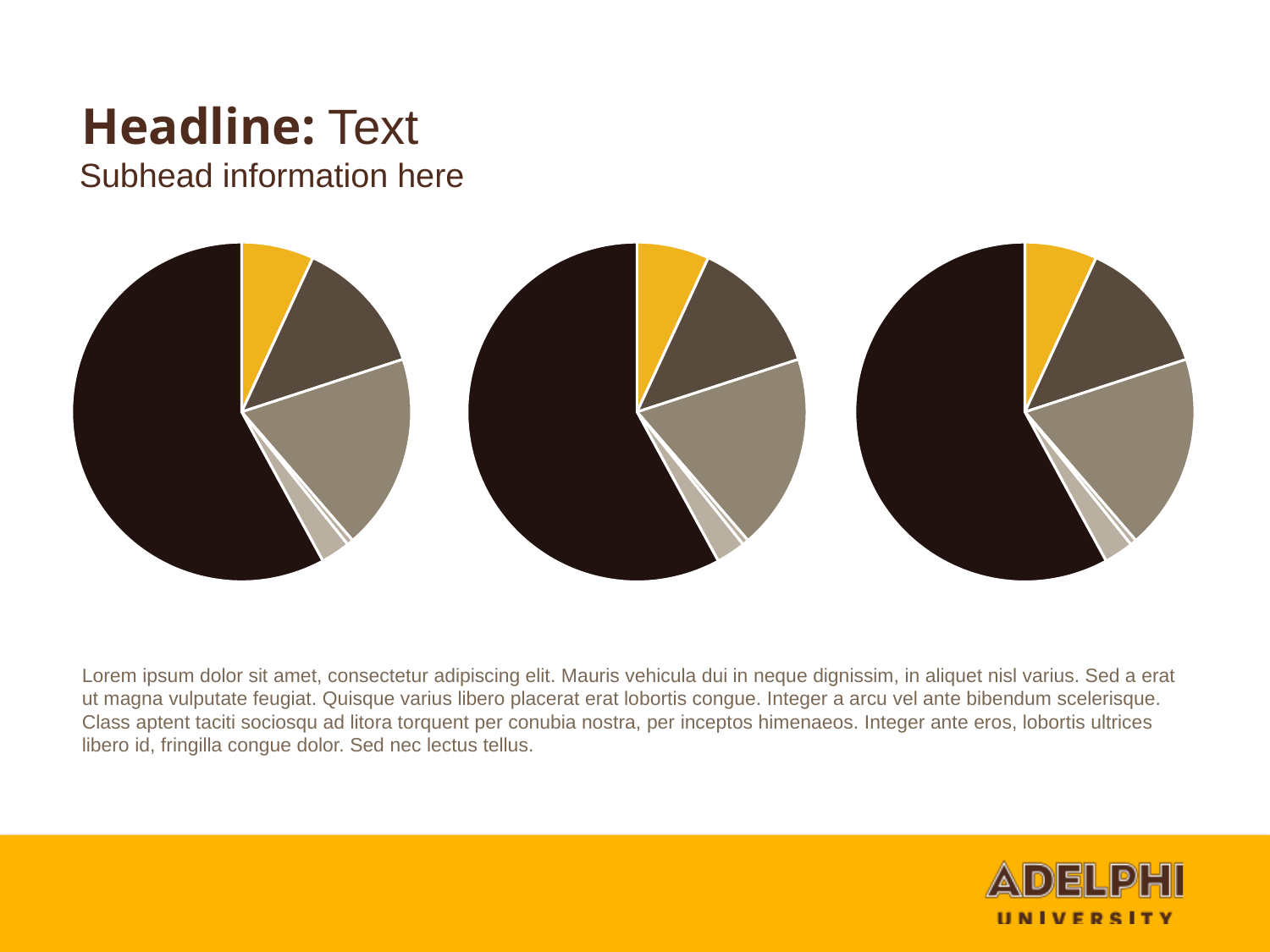
In the left pie chart, which is larger, the yellow slice or the medium grey slice? The medium grey slice What kind of chart is shown on the slide? Pie chart Do the pie charts on the slide include a legend? No In the left pie chart, is the dark brown slice more or less than half of the pie? More In the middle pie chart, which colour slice is the largest? Dark brown Do the pie charts on the slide show data labels? No How many pie charts are on the slide? 3 In the right pie chart, which colour slice is the largest? Dark brown In the left pie chart, which colour slice is the largest? Dark brown In the right pie chart, which is larger, the yellow slice or the dark brown slice? The dark brown slice